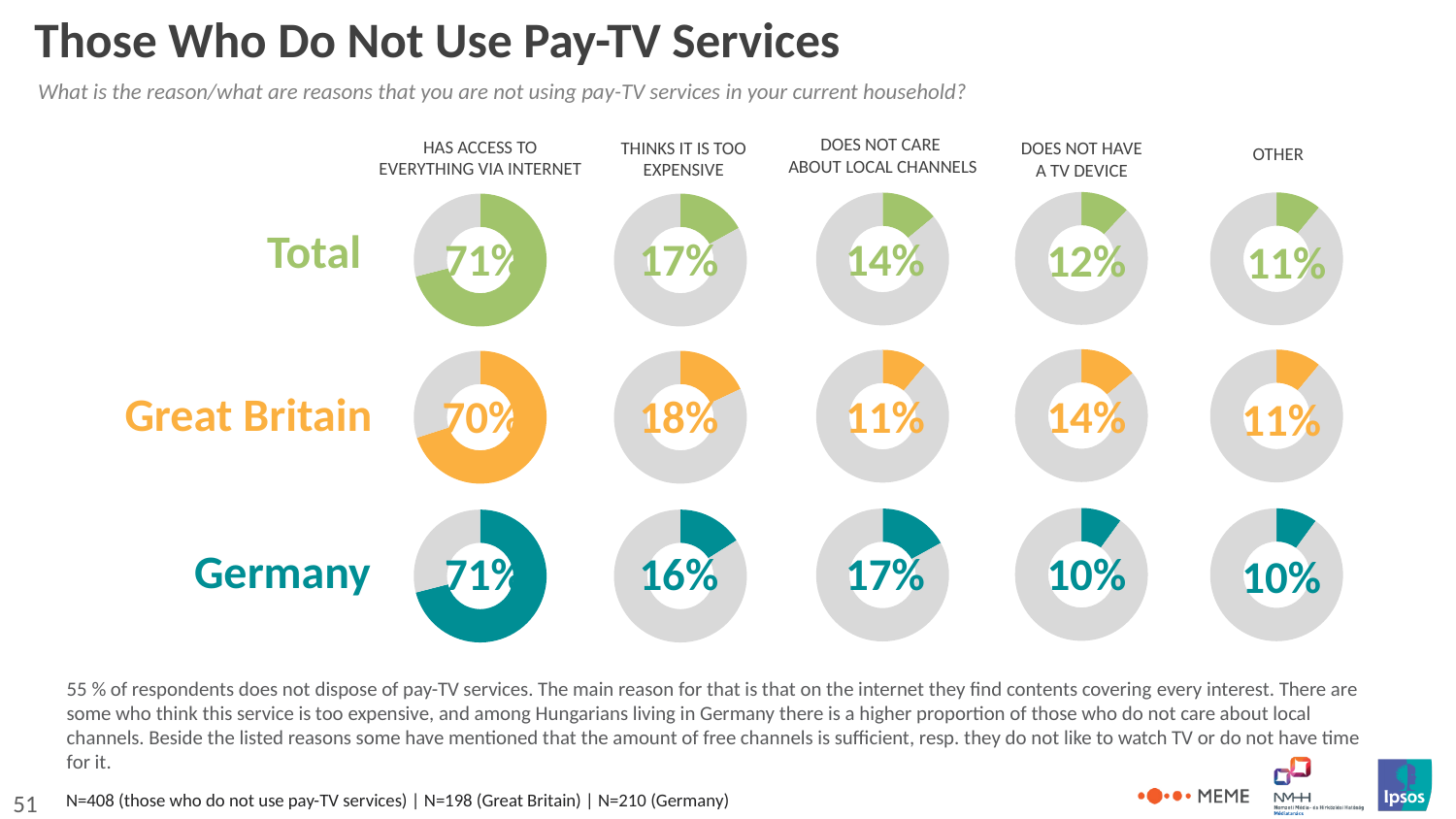
What percentage of Germany respondents do not care about local channels? 17% Which reason has the lowest percentage in the Germany row? Does not have a TV device and Other (both 10%) Which reason has the highest percentage in the Total row? Has access to everything via internet For 'Thinks it is too expensive', which is larger: Great Britain or Germany? Great Britain What is the difference between the Great Britain and Germany percentages for 'Does not care about local channels'? 6 percentage points What percentage of the Total group says they have access to everything via internet? 71% What percentage of Germany respondents gave 'Other' as a reason? 10% What percentage of Great Britain respondents think pay-TV is too expensive? 18% What type of chart is used to display each value on the slide? Donut (pie) chart What colour is used for the Germany row of charts? Teal What percentage of Great Britain respondents do not have a TV device? 14% How many reason categories are shown across the top of the chart grid? 5